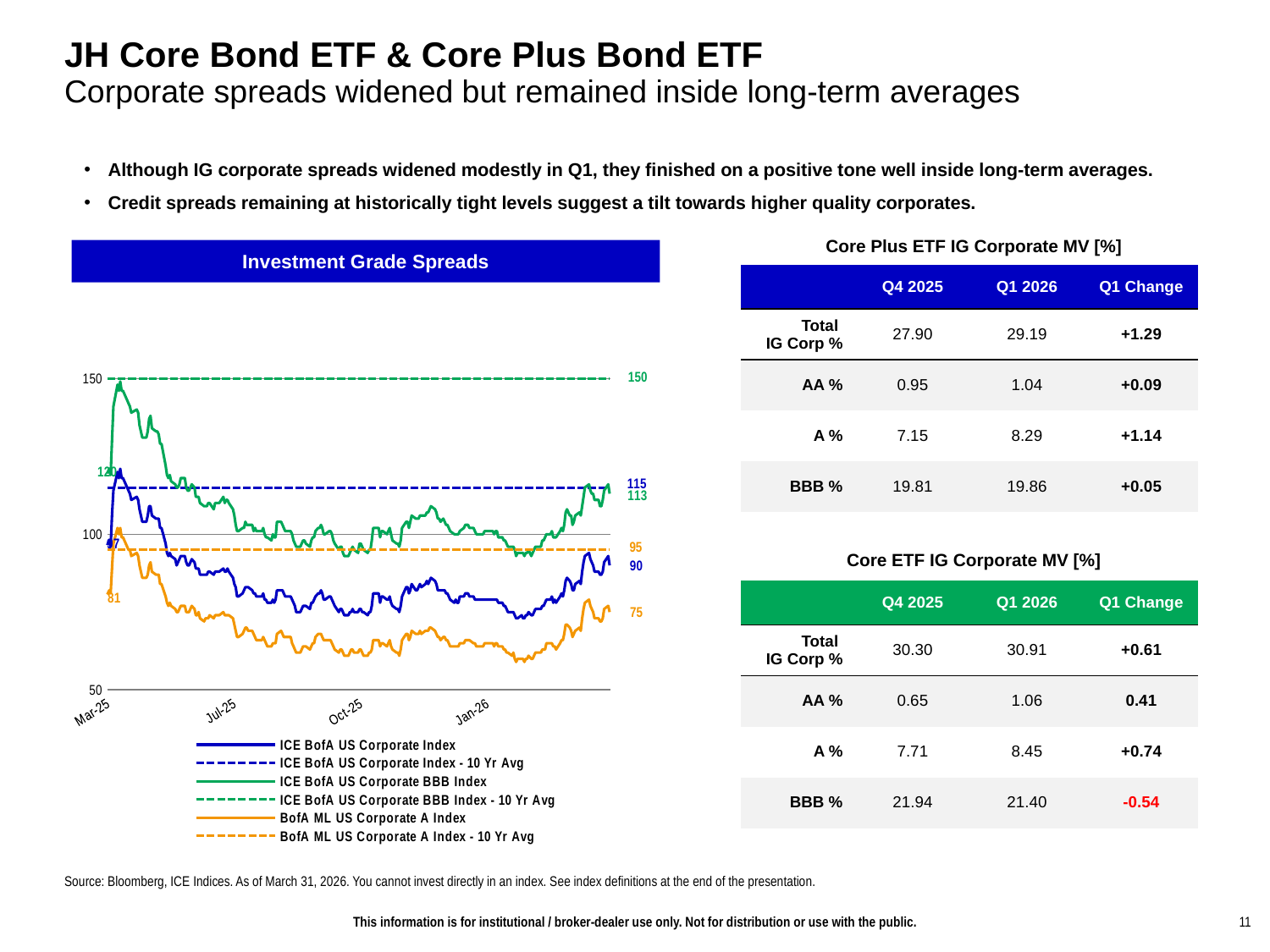
On the Investment Grade Spreads chart, which ends higher: the ICE BofA US Corporate BBB Index or the BofA ML US Corporate A Index? ICE BofA US Corporate BBB Index What is the final labelled value of the ICE BofA US Corporate Index on the Investment Grade Spreads chart? 90 What is the value of the BofA ML US Corporate A Index - 10 Yr Avg line on the Investment Grade Spreads chart? 95 On the Investment Grade Spreads chart, how far below its 10 Yr Avg is the final value of the ICE BofA US Corporate BBB Index? 37 What is the final labelled value of the BofA ML US Corporate A Index on the Investment Grade Spreads chart? 75 What kind of chart is the Investment Grade Spreads chart? line chart What is the value of the ICE BofA US Corporate BBB Index - 10 Yr Avg line on the Investment Grade Spreads chart? 150 What is the value of the ICE BofA US Corporate Index - 10 Yr Avg line on the Investment Grade Spreads chart? 115 What is the final labelled value of the ICE BofA US Corporate BBB Index on the Investment Grade Spreads chart? 113 On the Investment Grade Spreads chart, is the BofA ML US Corporate A Index at Oct-25 greater or less than 100? less How many series does the legend of the Investment Grade Spreads chart list? 6 On the Investment Grade Spreads chart, how far below its 10 Yr Avg is the final value of the ICE BofA US Corporate Index? 25